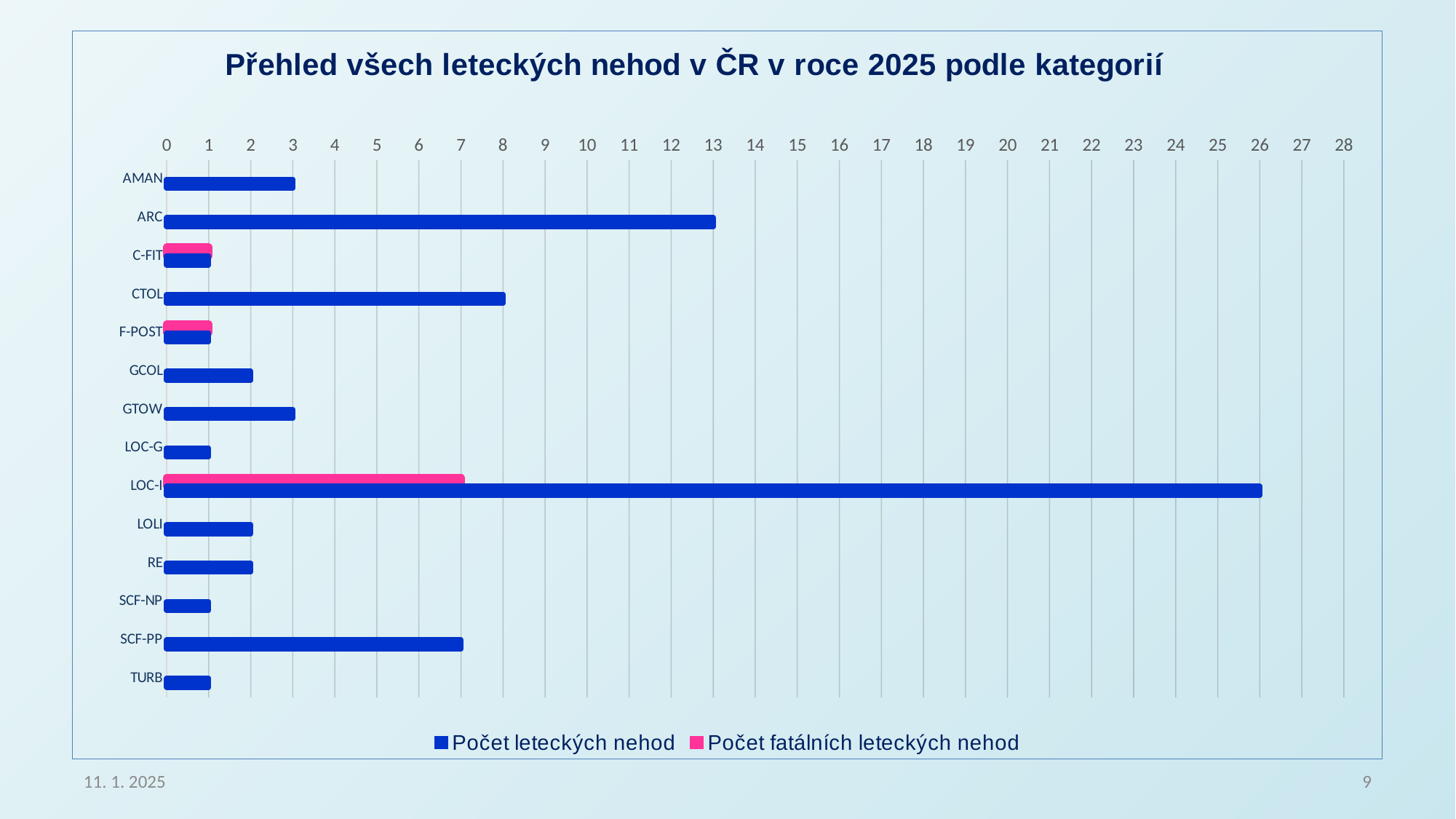
What kind of chart is shown on the slide? bar chart What is the value of Počet leteckých nehod for ARC? 13 What is the value of Počet fatálních leteckých nehod for LOC-I? 7 How many categories are shown on the vertical axis? 14 What is the value of Počet leteckých nehod for CTOL? 8 What is the value of Počet leteckých nehod for LOC-I? 26 What is the title of the chart? Přehled všech leteckých nehod v ČR v roce 2025 podle kategorií Is the value of Počet leteckých nehod for LOC-I greater or less than 20? greater Which category has the highest value for Počet leteckých nehod? LOC-I How many series does the legend list? 2 Which is larger, Počet leteckých nehod for ARC or for SCF-PP? ARC What is the difference between Počet leteckých nehod for LOC-I and for ARC? 13